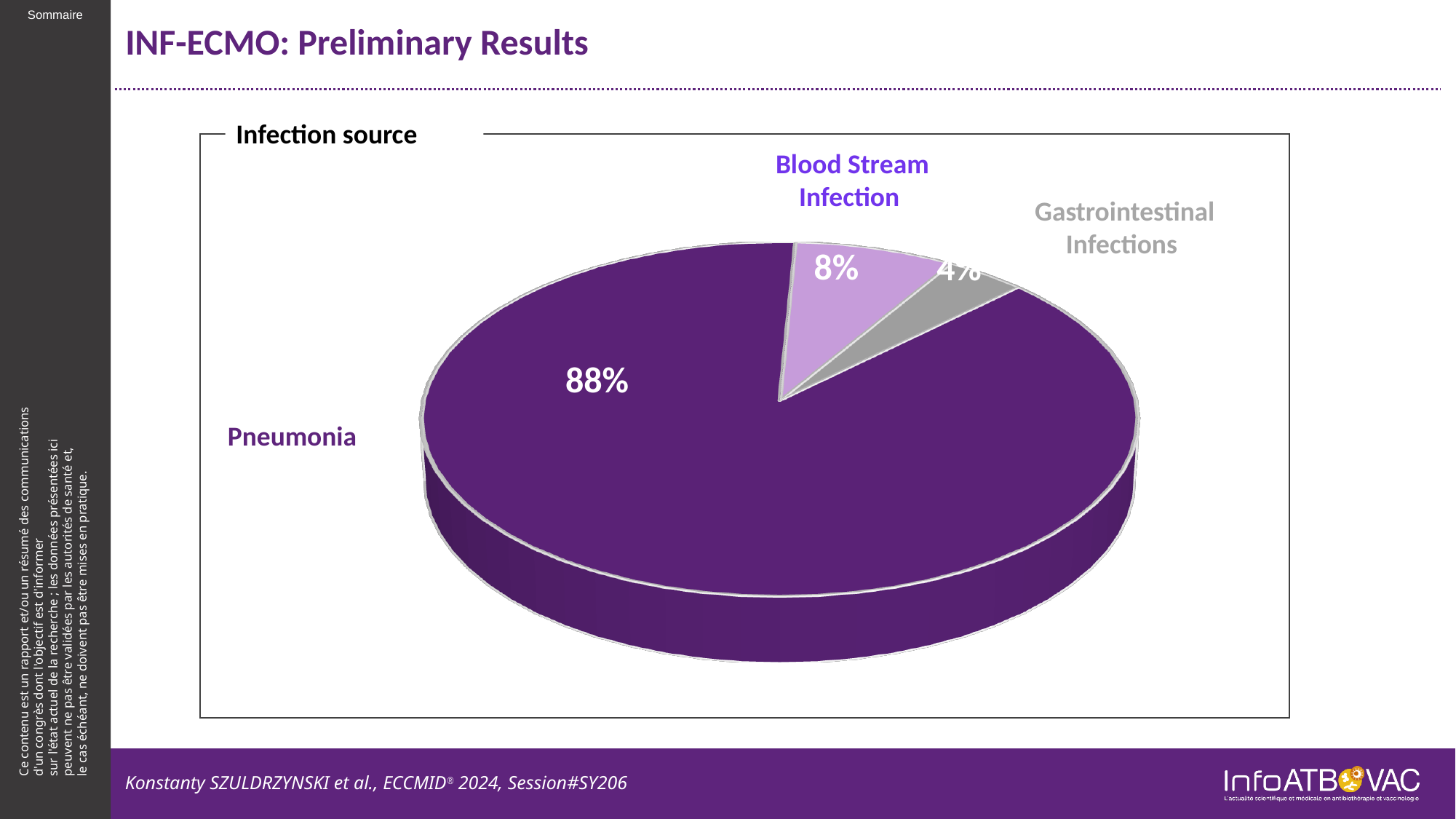
How many infection source categories are shown in the pie chart? 3 What is the difference in percentage points between the Pneumonia share and the Blood Stream Infection share? 80 What share of the pie does Pneumonia account for? 88% What is the difference in percentage points between the Blood Stream Infection share and the Gastrointestinal Infections share? 4 Which has a larger share, Blood Stream Infection or Gastrointestinal Infections? Blood Stream Infection What colour is the Gastrointestinal Infections slice? Grey What share of the pie does Blood Stream Infection account for? 8% What is the title of the chart? Infection source Which infection source has the smallest share of the pie? Gastrointestinal Infections Which infection source has the largest share of the pie? Pneumonia What kind of chart is shown on the slide? Pie chart What share of the pie does Gastrointestinal Infections account for? 4%